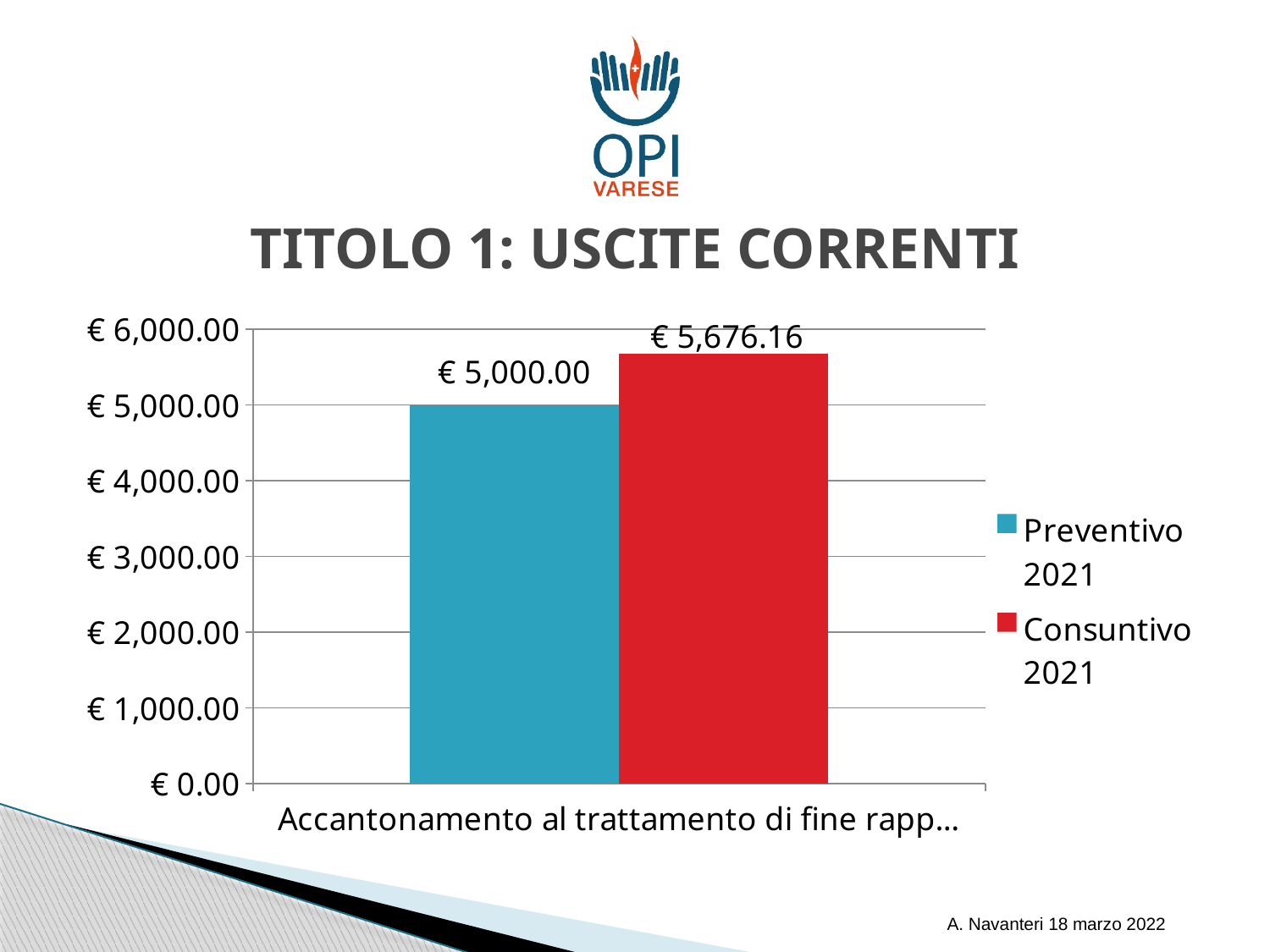
Which series has the higher value, Preventivo 2021 or Consuntivo 2021? Consuntivo 2021 What is the difference between Consuntivo 2021 and Preventivo 2021? € 676.16 Is the value for Consuntivo 2021 greater or less than € 6,000.00? less What colour is the bar for Consuntivo 2021? red What is the title of the slide above the chart? TITOLO 1: USCITE CORRENTI How many series does the legend list? 2 Is the value for Preventivo 2021 greater or less than € 4,000.00? greater What is the value for Consuntivo 2021? € 5,676.16 What kind of chart is shown on the slide? bar chart Which series has the lowest value? Preventivo 2021 What is the value for Preventivo 2021? € 5,000.00 How many categories are shown on the x axis? 1